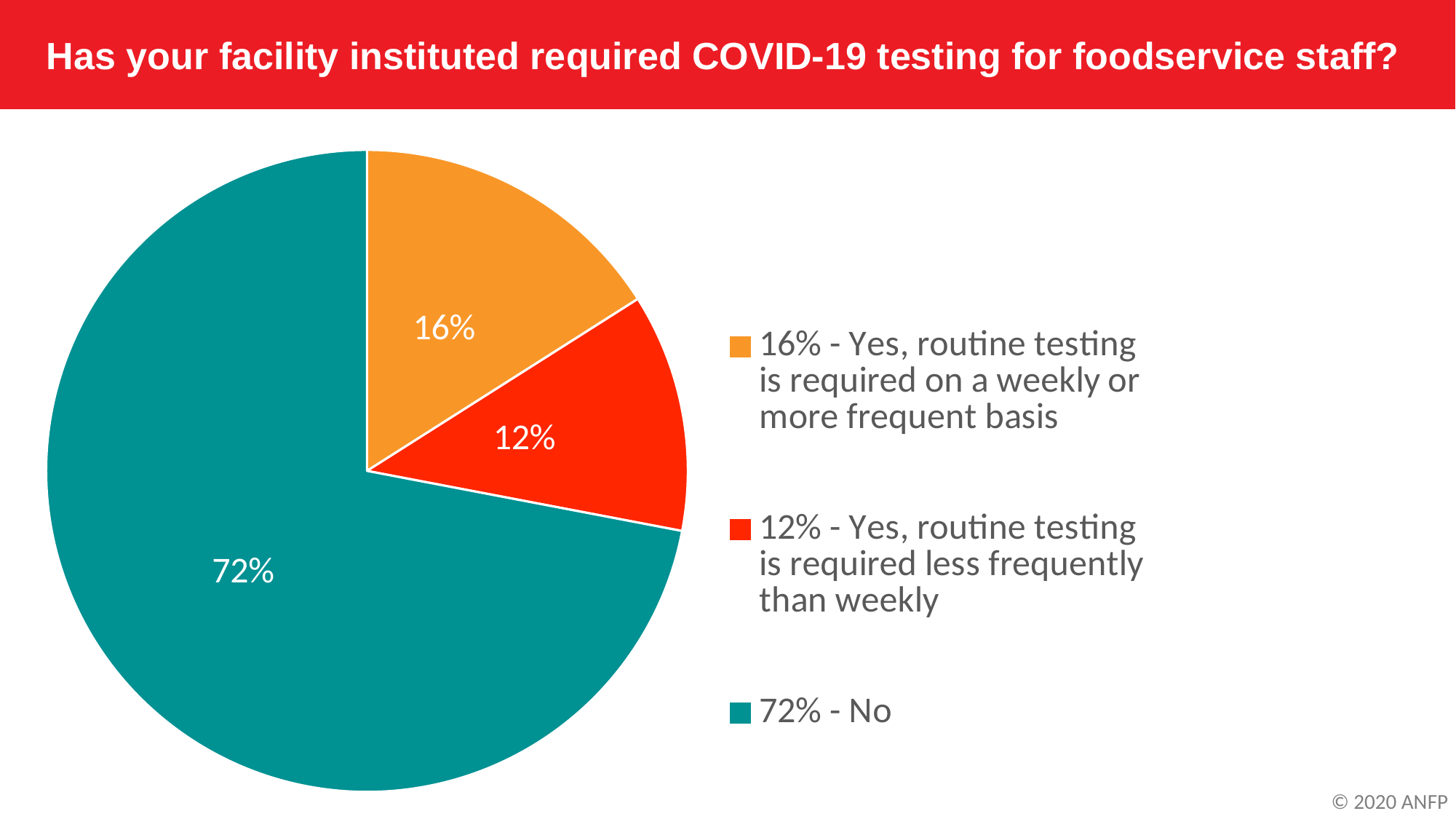
How many slices does the pie chart have? 3 What colour is the slice representing "No"? teal What is the combined share of respondents who answered "Yes" (either testing frequency)? 28% What share of respondents said routine testing is required on a weekly or more frequent basis? 16% What is the difference in percentage points between the "No" slice and the weekly-or-more-frequent testing slice? 56 How many entries does the legend list? 3 What share of respondents said routine testing is required less frequently than weekly? 12% Which is larger: the share for weekly or more frequent testing, or the share for testing less frequently than weekly? weekly or more frequent testing What share of respondents answered "No"? 72% Which response has the smallest slice of the pie? Yes, routine testing is required less frequently than weekly What kind of chart is shown on the slide? pie chart Which response has the largest slice of the pie? No